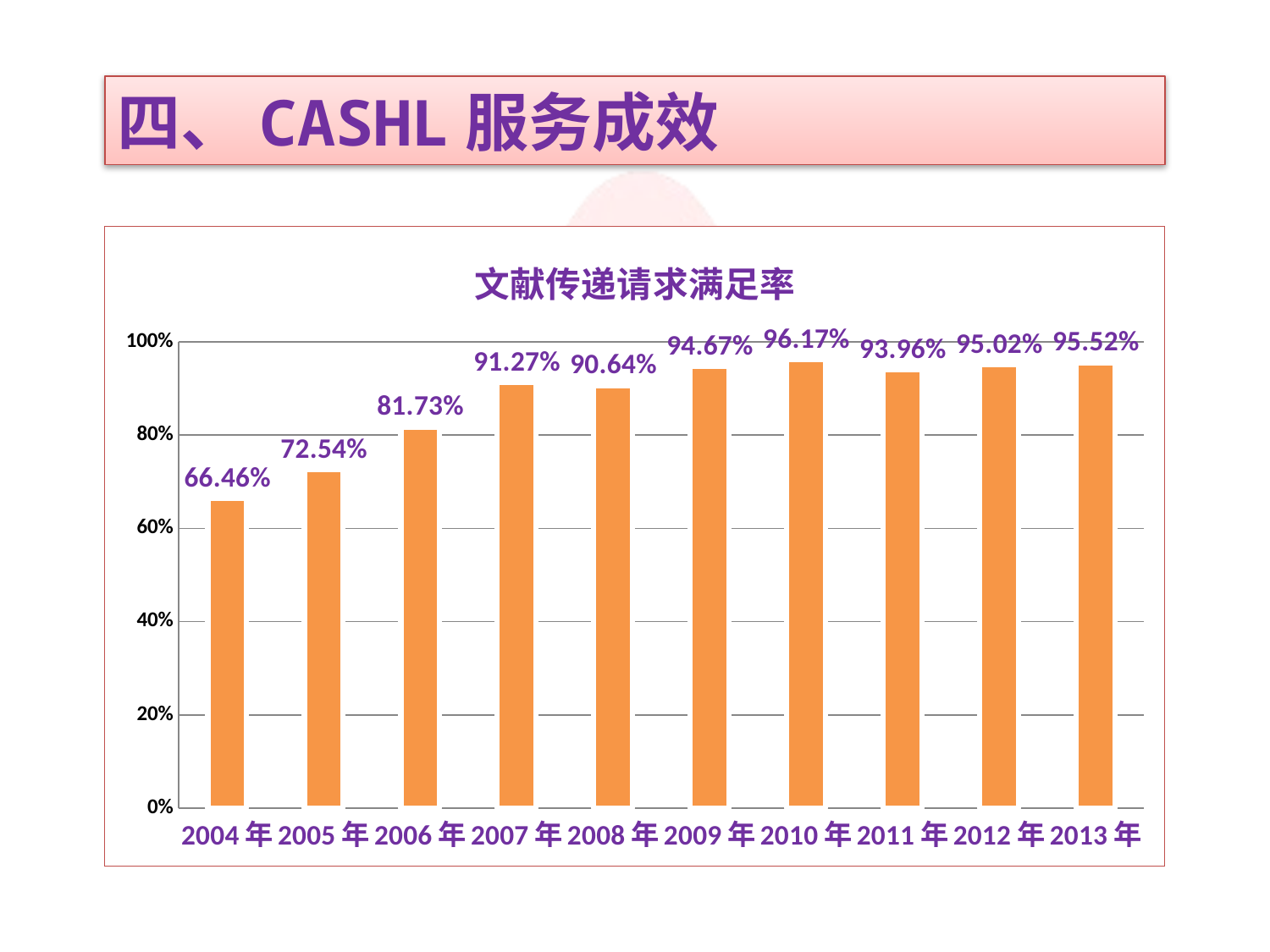
Which year has the lowest value? 2004年 Which is larger, the value for 2007年 or the value for 2008年? 2007年 What is the value for 2013年? 95.52% What is the value for 2004年? 66.46% Which year has the highest value? 2010年 Do the values generally rise or fall from 2004年 to 2013年? rise What is the value for 2010年? 96.17% What is the title of the chart? 文献传递请求满足率 What is the difference between the values for 2006年 and 2005年? 9.19% Is the value for 2006年 greater or less than 80%? greater What kind of chart is this? bar chart How many years are shown on the x axis? 10